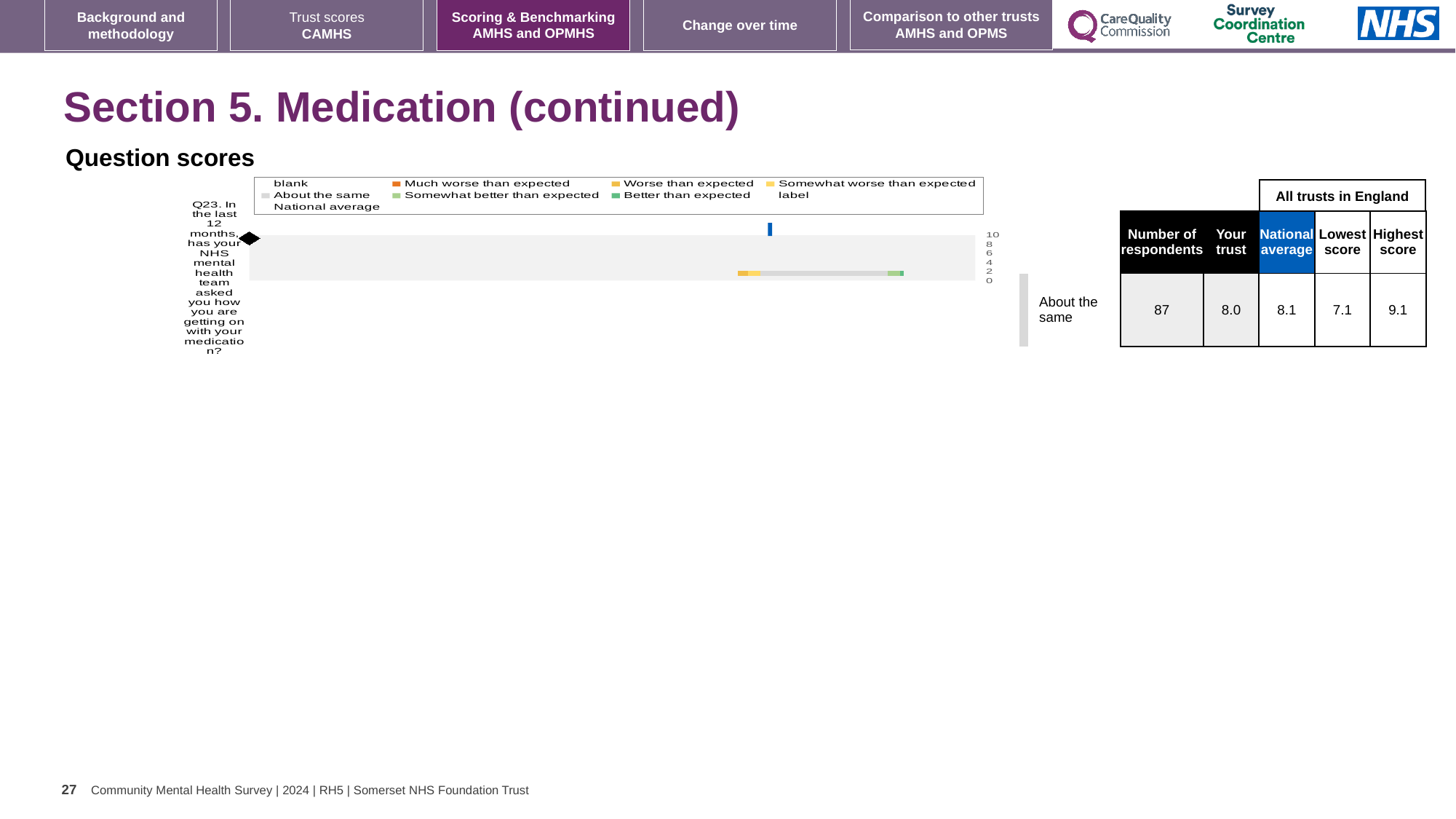
How many respondents answered Q23? 87 What is the difference between the highest and lowest trust scores for Q23? 2.0 Which is larger for Q23: the 'Your trust' score or the national average? National average What is the difference between the national average and the 'Your trust' score for Q23? 0.1 What kind of chart is shown on the slide? bar chart How many questions (categories) are plotted in the chart? 1 What is the lowest score among all trusts in England for Q23? 7.1 What is the highest score among all trusts in England for Q23? 9.1 What is the national average score for Q23? 8.1 What benchmark category is the trust's Q23 result labelled as? About the same Which legend entry is shown in orange? Much worse than expected What is the 'Your trust' score for Q23 about being asked how you are getting on with your medication? 8.0